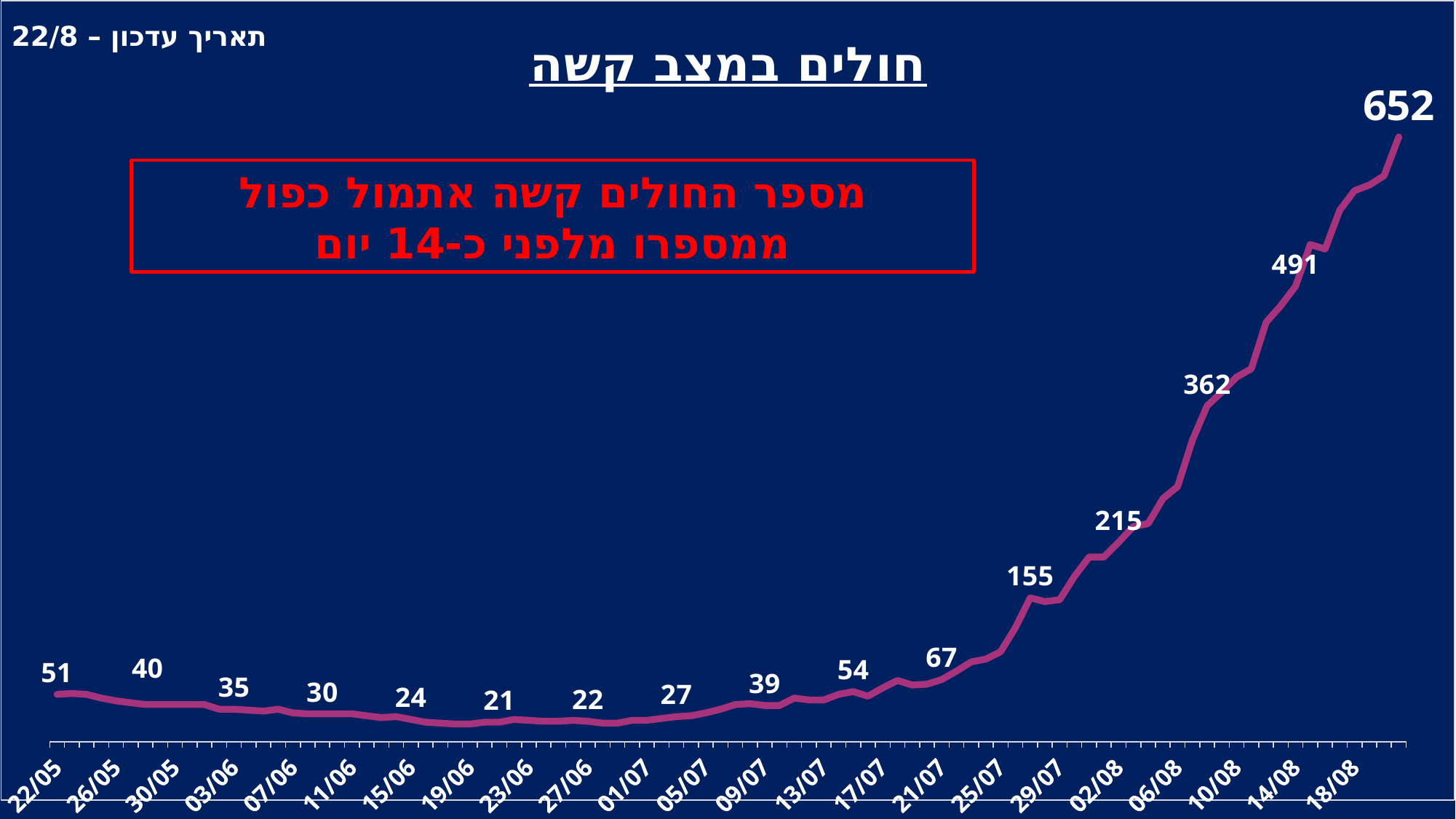
What is the update date shown in the top-left corner of the slide? 22/8 What is the difference between the last labelled value (652) and the previous labelled value (491)? 161 How many data labels are printed along the line? 16 Which is larger: the labelled value 362 or the labelled value 215? 362 What is the value of the first data point on the chart, at 22/05? 51 What is the value of the last data point on the chart (the rightmost label)? 652 What is the lowest value labelled on the chart? 21 What is the title of the chart? חולים במצב קשה Does the line rise or fall over the last part of the chart, from 21/07 to the end? rises What kind of chart is shown on the slide? line chart What is the highest value labelled on the chart? 652 What is the difference between the last labelled value (652) and the first labelled value (51)? 601